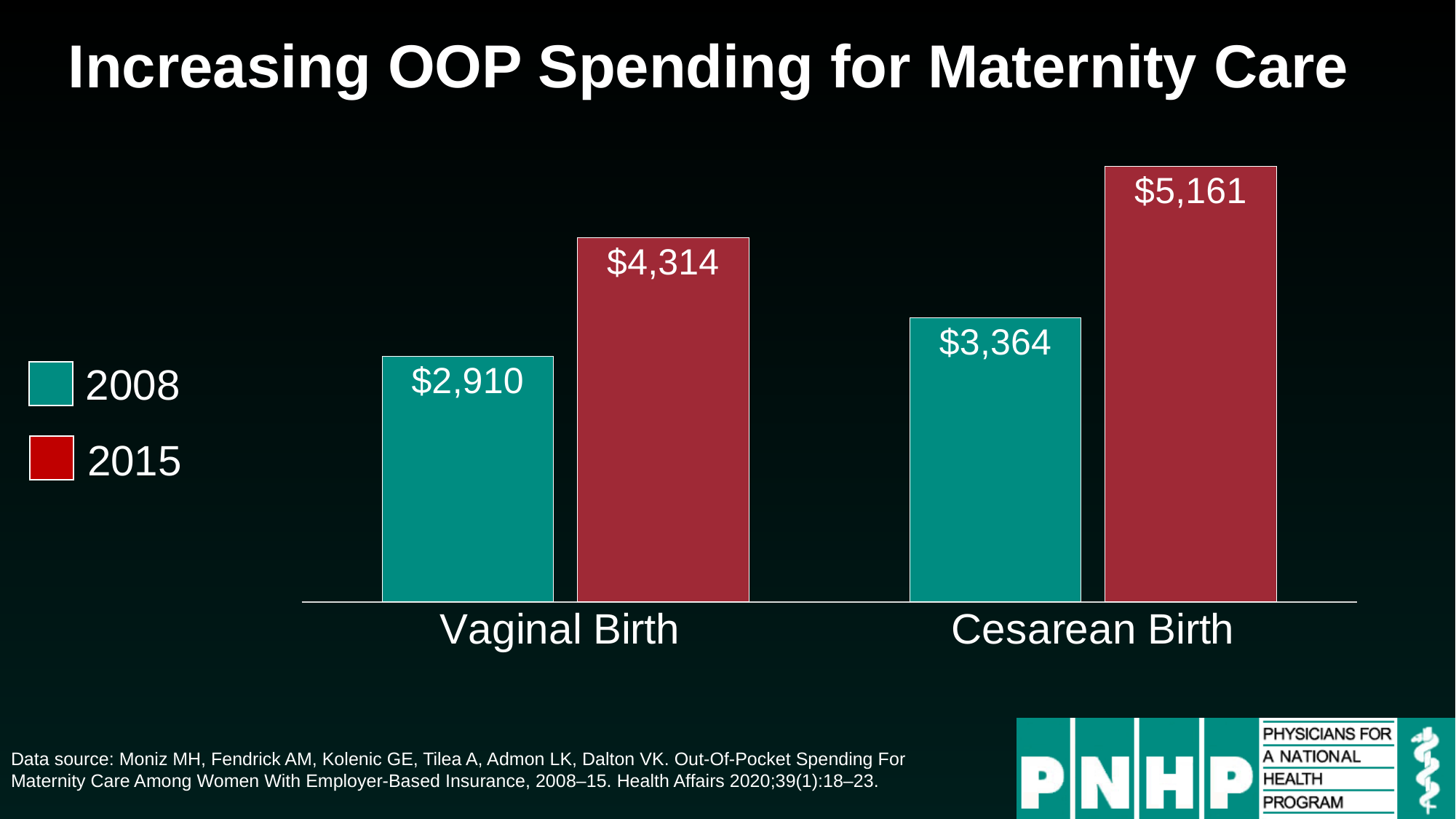
What was the out-of-pocket spending for a vaginal birth in 2008? $2,910 How many birth-type categories are shown on the x axis? 2 Which bar shows the highest value on the chart? Cesarean Birth, 2015 How many series does the legend list? 2 How much did out-of-pocket spending for a vaginal birth increase from 2008 to 2015? $1,404 Which was larger in 2015: spending for a vaginal birth or a cesarean birth? Cesarean Birth Which bar shows the lowest value on the chart? Vaginal Birth, 2008 What was the out-of-pocket spending for a vaginal birth in 2015? $4,314 What type of chart is shown on the slide? Bar chart How much did out-of-pocket spending for a cesarean birth increase from 2008 to 2015? $1,797 What was the out-of-pocket spending for a cesarean birth in 2008? $3,364 What was the out-of-pocket spending for a cesarean birth in 2015? $5,161